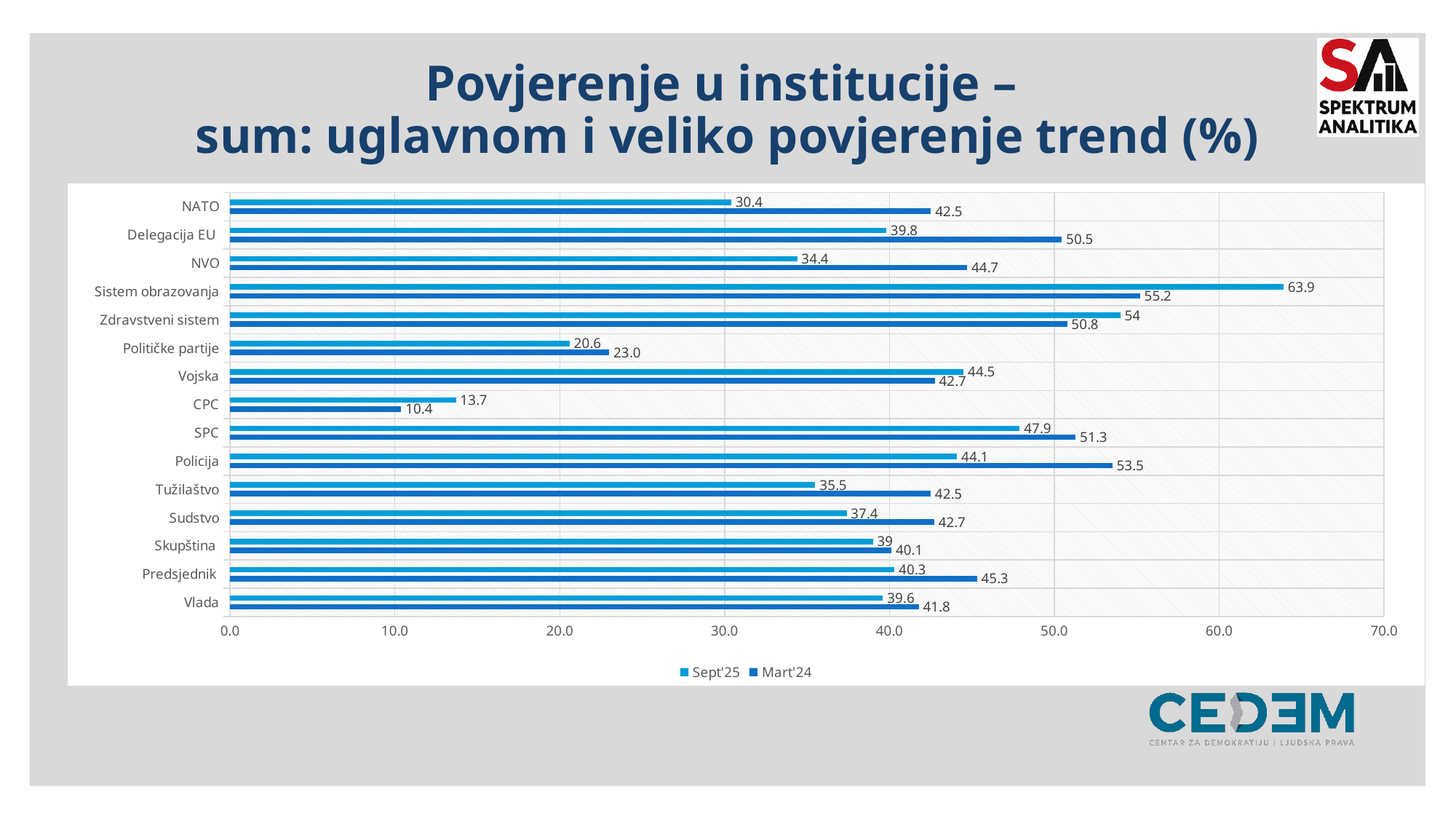
Is the Sept'25 value for Političke partije greater or less than 30.0? less Which institution has the lowest Mart'24 value? CPC What is the Sept'25 value for NATO? 30.4 What is the Mart'24 value for Delegacija EU? 50.5 What kind of chart is shown on the slide? bar chart How many series does the legend list? 2 What is the difference between the Mart'24 and Sept'25 values for Policija? 9.4 For Vojska, which is larger: the Sept'25 value or the Mart'24 value? Sept'25 What are the two series named in the legend? Sept'25 and Mart'24 What is the Sept'25 value for Zdravstveni sistem? 54 Which institution has the highest Sept'25 value? Sistem obrazovanja How many institutions are listed on the chart? 15